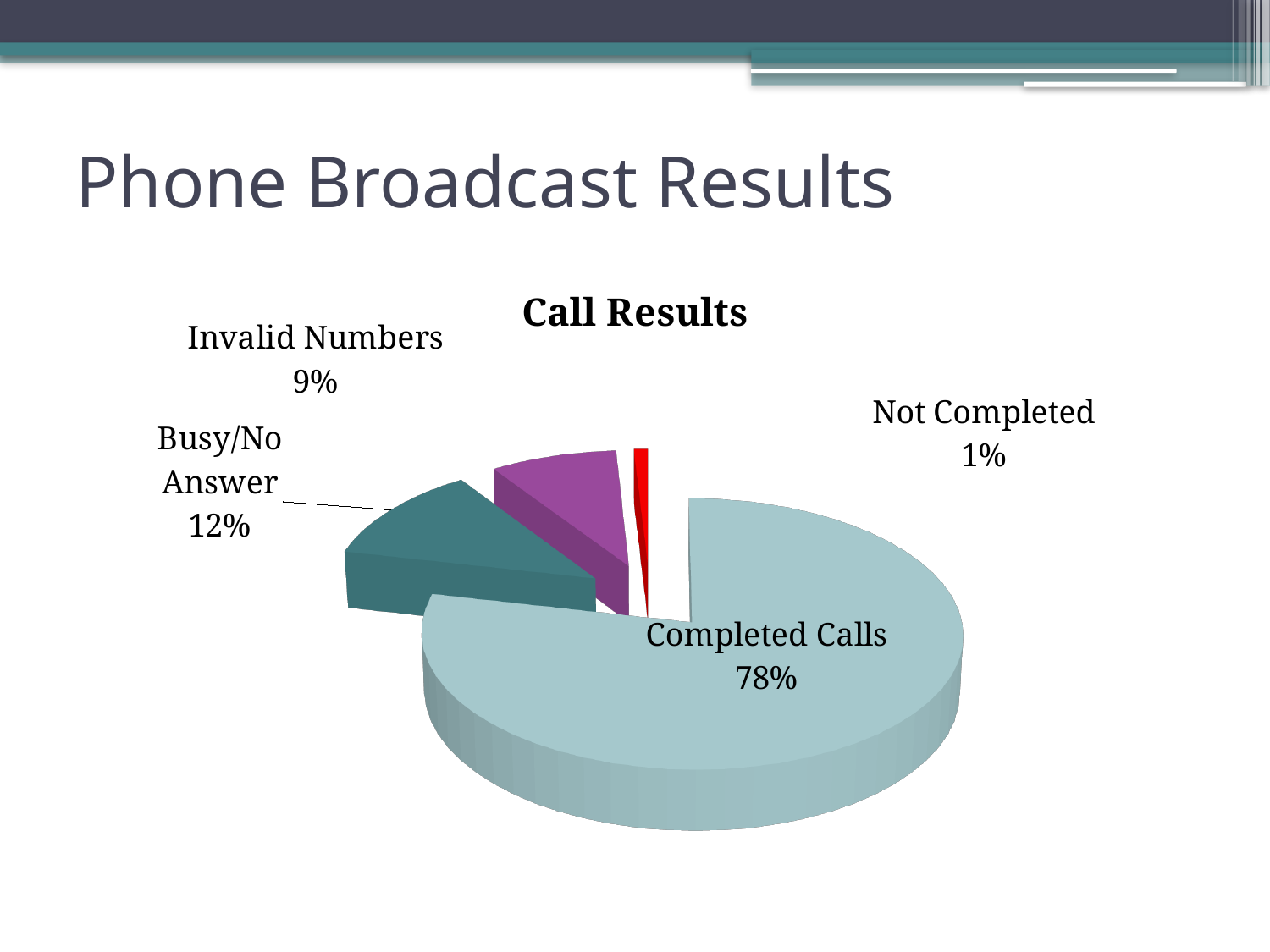
Which category has the largest slice of the pie? Completed Calls What percentage is shown for Busy/No Answer? 12% How many slices does the pie chart have? 4 What percentage is shown for Invalid Numbers? 9% What is the difference in percentage points between Busy/No Answer and Invalid Numbers? 3 What percentage is shown for Not Completed? 1% What share of the pie is Completed Calls? 78% What kind of chart is shown on the slide? pie chart What is the title of the chart? Call Results Which category has the smallest slice of the pie? Not Completed What colour is the Completed Calls slice? light blue Which is larger, Invalid Numbers or Busy/No Answer? Busy/No Answer